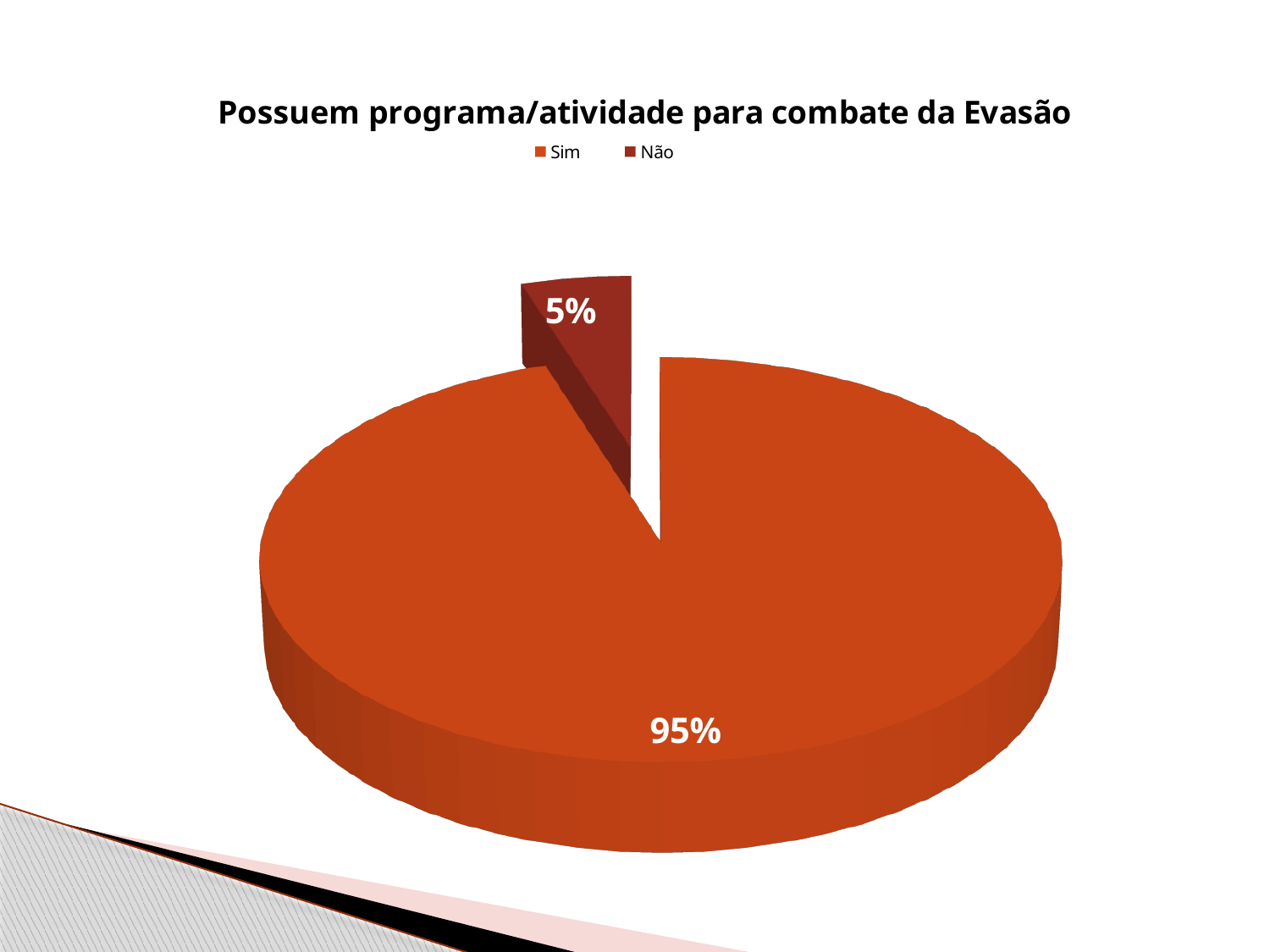
How many entries does the legend list? 2 Which slice is larger, "Sim" or "Não"? Sim What is the share of the pie represented by the "Não" slice? 5% What percentage of the pie chart corresponds to "Sim"? 95% What is the title of the chart? Possuem programa/atividade para combate da Evasão What type of chart is shown on the slide? Pie chart How many slices does the pie chart have? 2 What percentage of the pie chart corresponds to "Não"? 5% Which category has the smallest share of the pie chart? Não Which legend entry is shown in the darker red colour? Não What is the difference in percentage points between the "Sim" and "Não" slices? 90 Which category has the largest share of the pie chart? Sim